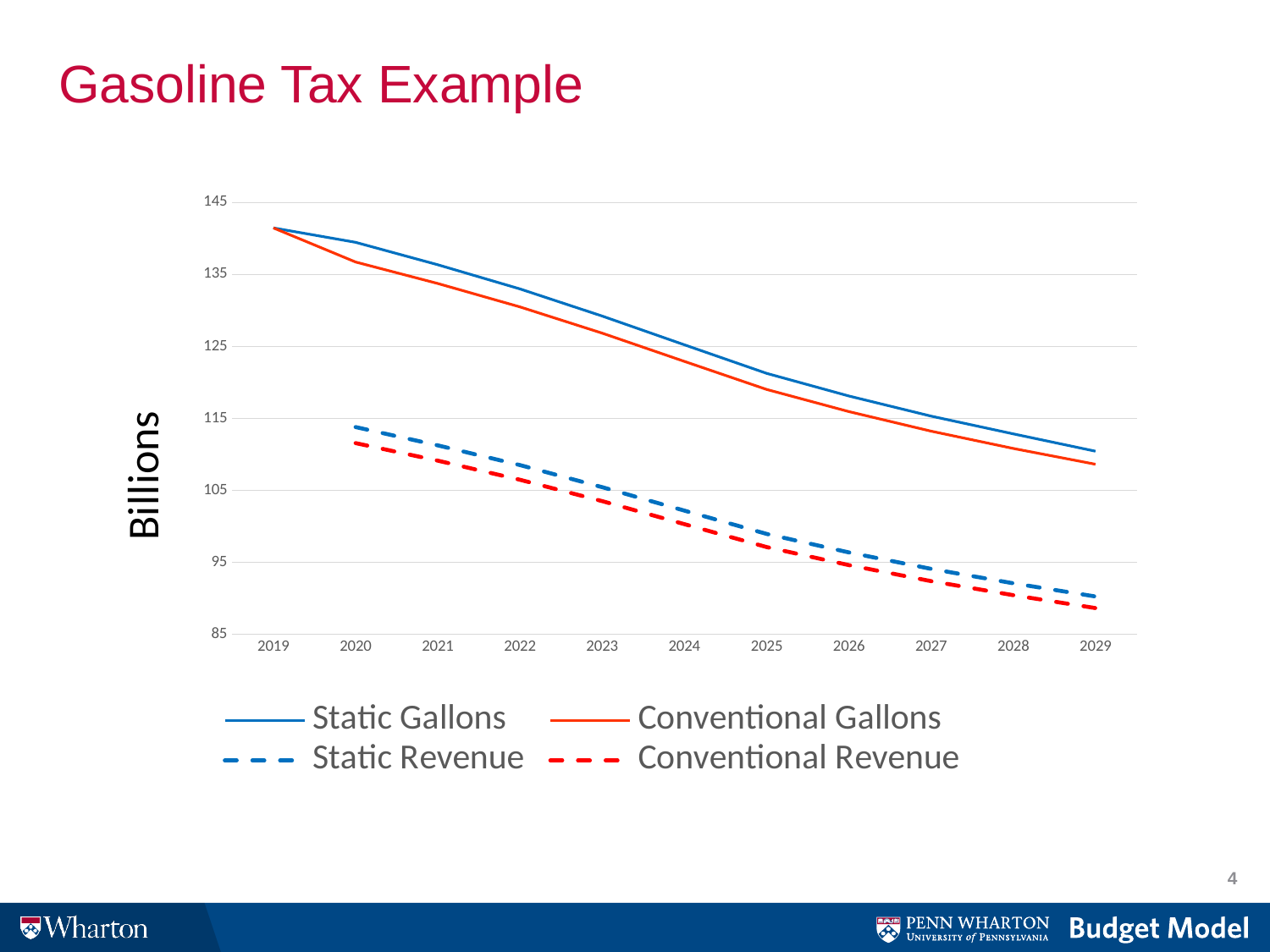
Do the Conventional Revenue values rise or fall from 2020 to 2029? Fall What is the label on the vertical axis of the chart? Billions Is the value for Static Gallons in 2019 greater or less than 135? greater Is the value for Static Gallons in 2029 greater or less than 115? less Do the Static Gallons values rise or fall from 2019 to 2029? Fall How many series does the chart's legend list? 4 Is the value for Conventional Gallons in 2025 greater or less than 115? greater In 2029, which is larger: Static Gallons or Conventional Gallons? Static Gallons Which series in the legend are drawn with dashed lines? Static Revenue and Conventional Revenue What kind of chart is shown on the slide? Line chart How many years are shown along the x axis of the chart? 11